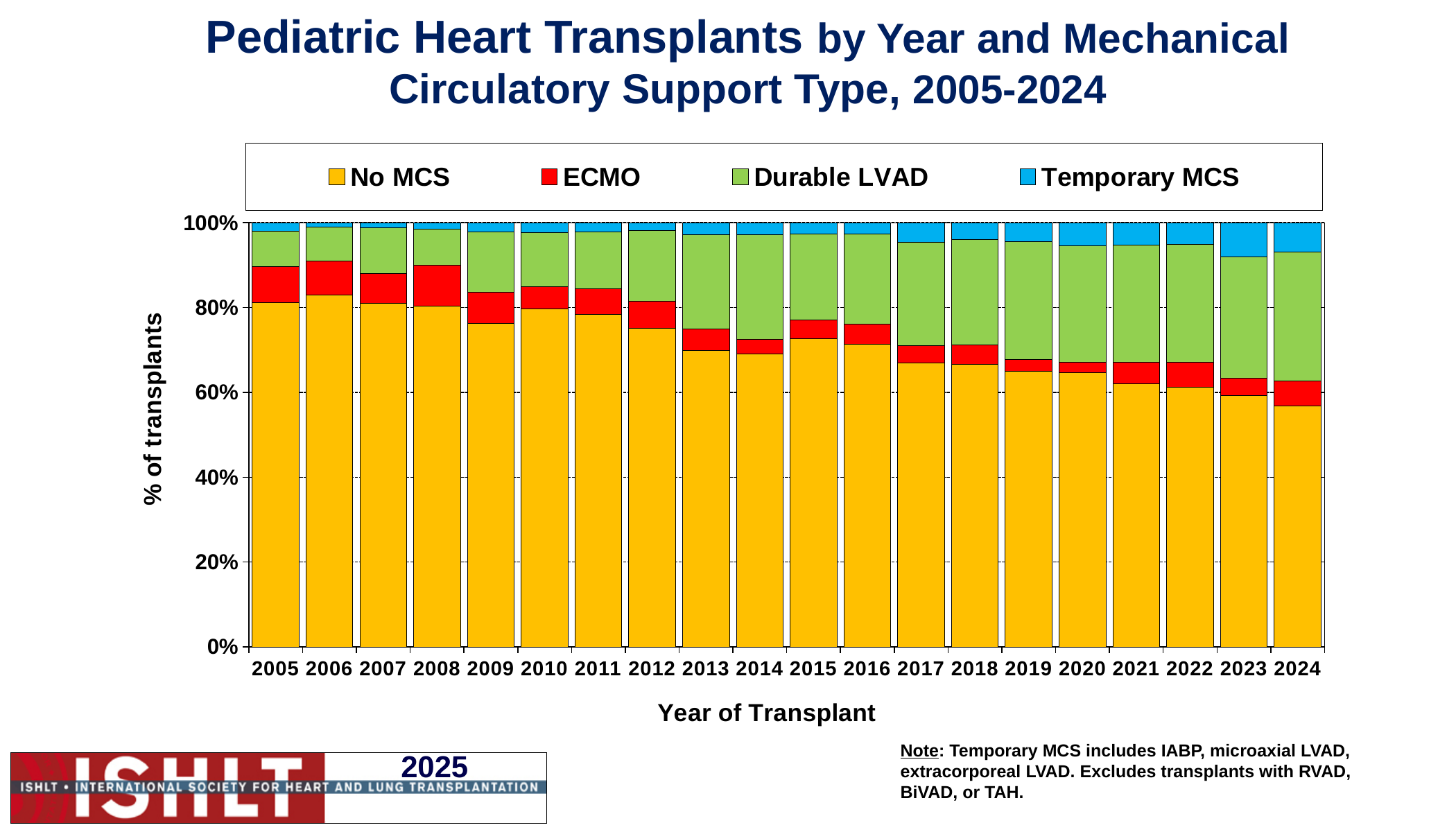
Which year has the lowest No MCS share? 2024 Which year has the highest No MCS share? 2006 Which series is shown in red in the legend? ECMO What is the label of the y axis? % of transplants How many years (categories) are shown along the x axis? 20 How many series does the legend list? 4 Is the No MCS share for 2024 greater or less than 60%? less Which year has the larger No MCS share, 2005 or 2024? 2005 Does the No MCS share generally rise or fall from 2005 to 2024? fall What kind of chart is shown on the slide? Stacked bar chart Is the No MCS share for 2013 greater or less than 80%? less Is the No MCS share for 2005 greater or less than 80%? greater